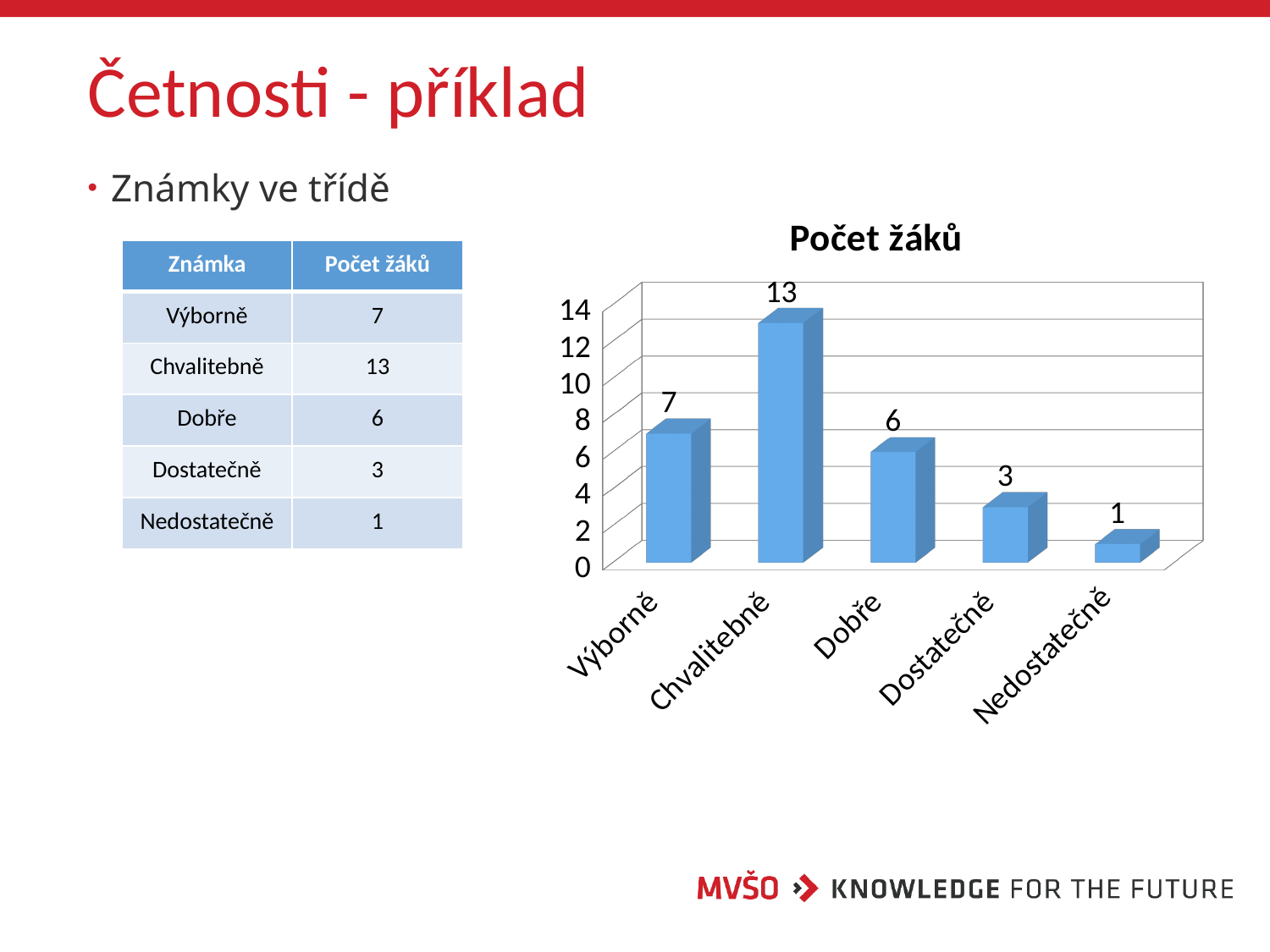
What is the title of the chart? Počet žáků Which category has the highest value in the chart? Chvalitebně What is the value for Chvalitebně in the chart? 13 What is the difference between the values for Chvalitebně and Výborně? 6 Which is larger, the value for Výborně or the value for Dobře? Výborně How many categories are shown in the chart? 5 Which category has the lowest value in the chart? Nedostatečně What is the value for Dostatečně in the chart? 3 Is the value for Chvalitebně greater or less than 10? greater What is the value for Nedostatečně in the chart? 1 What kind of chart is shown on the slide? bar chart What is the difference between the values for Dobře and Dostatečně? 3